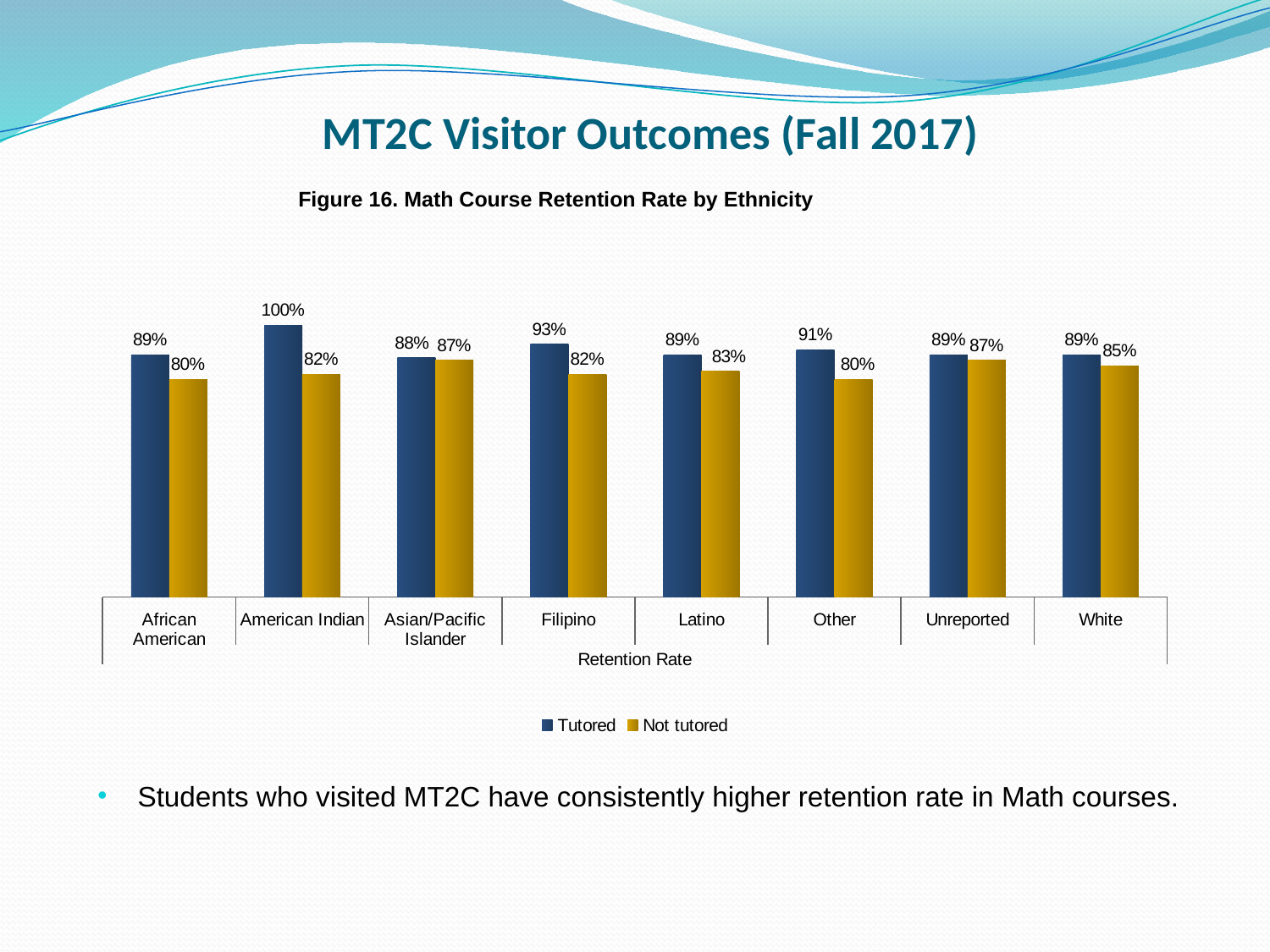
Which is larger, the Not tutored retention rate for Latino students or for Unreported students? Unreported What is the difference between the Tutored and Not tutored retention rates for American Indian students? 18% How many ethnicity categories are shown on the chart? 8 What is the Not tutored retention rate for Asian/Pacific Islander students? 87% What is the difference between the Tutored and Not tutored retention rates for Other students? 11% Which ethnicity has the highest Tutored retention rate? American Indian What kind of chart is shown on the slide? Bar chart What is the Tutored retention rate for American Indian students? 100% What is the Tutored retention rate for Filipino students? 93% Which ethnicity has the lowest Tutored retention rate? Asian/Pacific Islander How many series does the legend list? 2 What is the Not tutored retention rate for White students? 85%